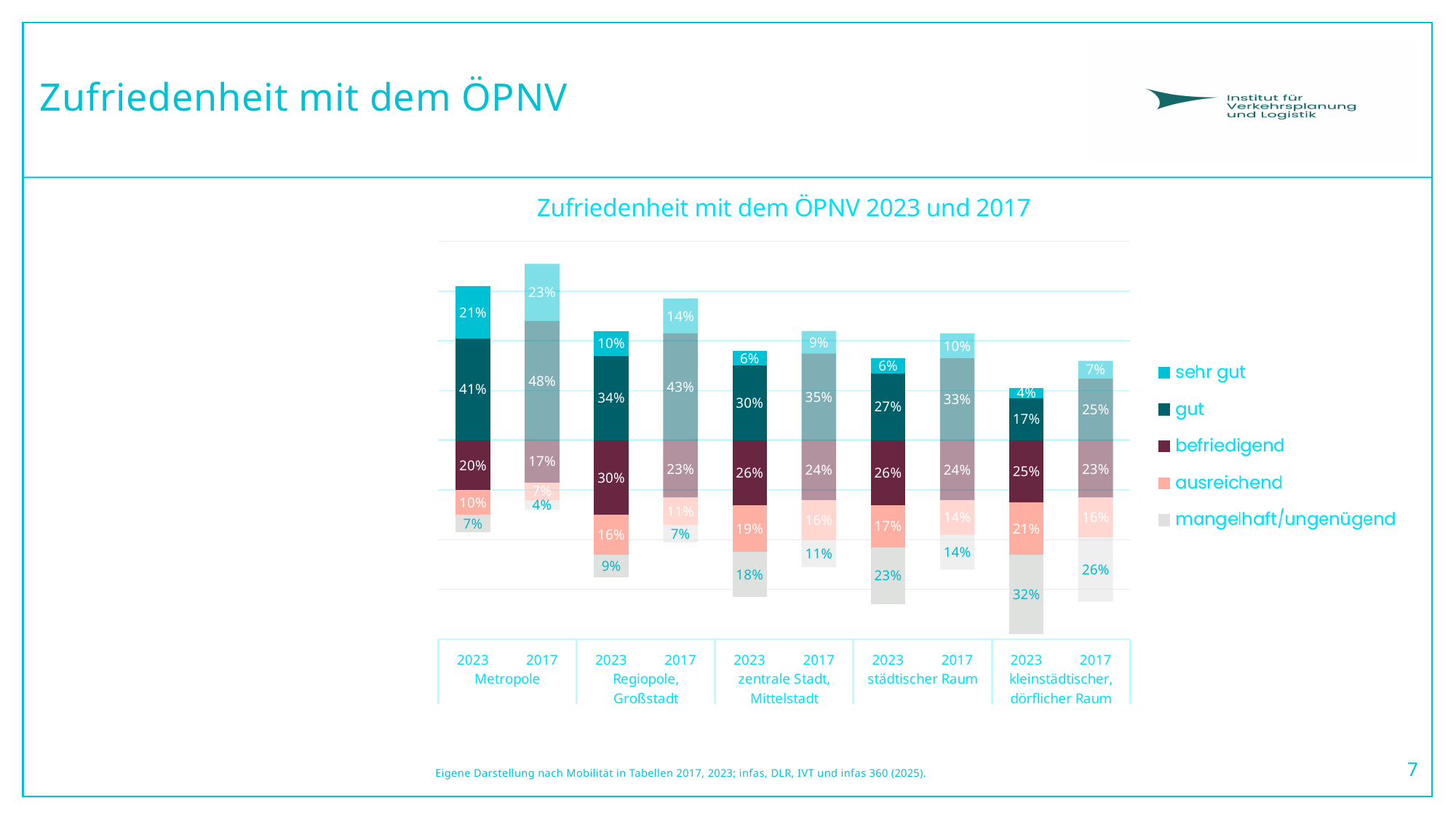
How many bars are plotted in the chart? 10 What is the 'mangelhaft/ungenügend' share for kleinstädtischer, dörflicher Raum in 2023? 32% What is the difference between the 'mangelhaft/ungenügend' share for kleinstädtischer, dörflicher Raum in 2023 and in 2017? 6% What is the 'ausreichend' share for zentrale Stadt, Mittelstadt in 2017? 16% What is the 'gut' share for Regiopole, Großstadt in 2023? 34% What is the title of the chart? Zufriedenheit mit dem ÖPNV 2023 und 2017 Which is larger: the 'befriedigend' share for Regiopole, Großstadt in 2023 or in 2017? 2023 How many series does the legend list? 5 Which bar has the lowest 'sehr gut' share? kleinstädtischer, dörflicher Raum 2023 Which bar has the highest 'gut' share? Metropole 2017 What is the 'sehr gut' share for Metropole in 2017? 23% What kind of chart is shown on the slide? stacked bar chart